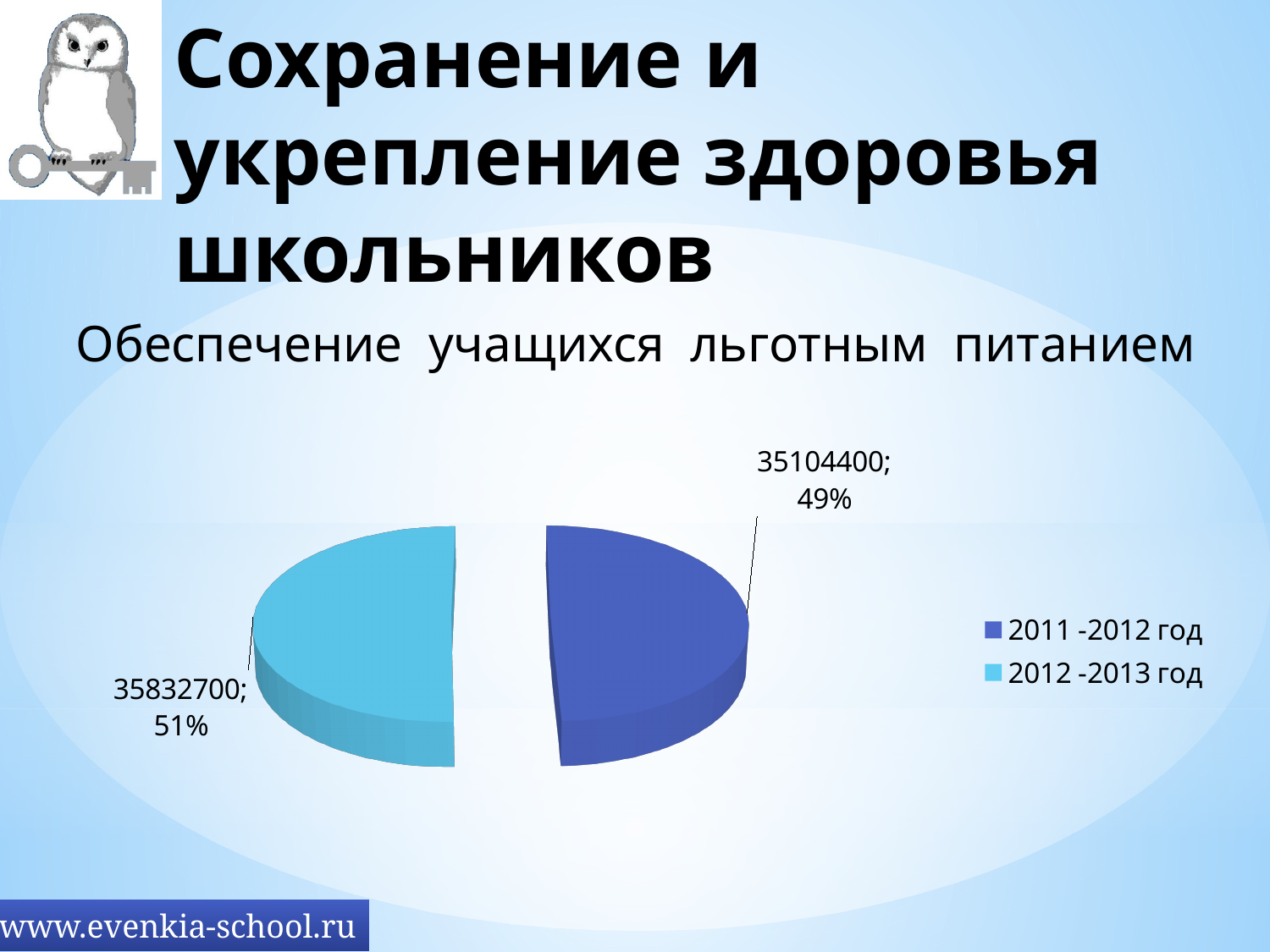
What colour is the slice for 2012 -2013 год? light blue Which category has the smallest slice of the pie? 2011 -2012 год Which is larger, the value for 2011 -2012 год or the value for 2012 -2013 год? 2012 -2013 год What share of the pie does the 2012 -2013 год slice represent? 51% What is the difference between the values for 2012 -2013 год and 2011 -2012 год? 728300 Which category has the largest slice of the pie? 2012 -2013 год What is the value for 2011 -2012 год? 35104400 How many slices does the pie chart have? 2 How many entries does the legend list? 2 What share of the pie does the 2011 -2012 год slice represent? 49% What kind of chart is shown on the slide? pie chart What is the value for 2012 -2013 год? 35832700